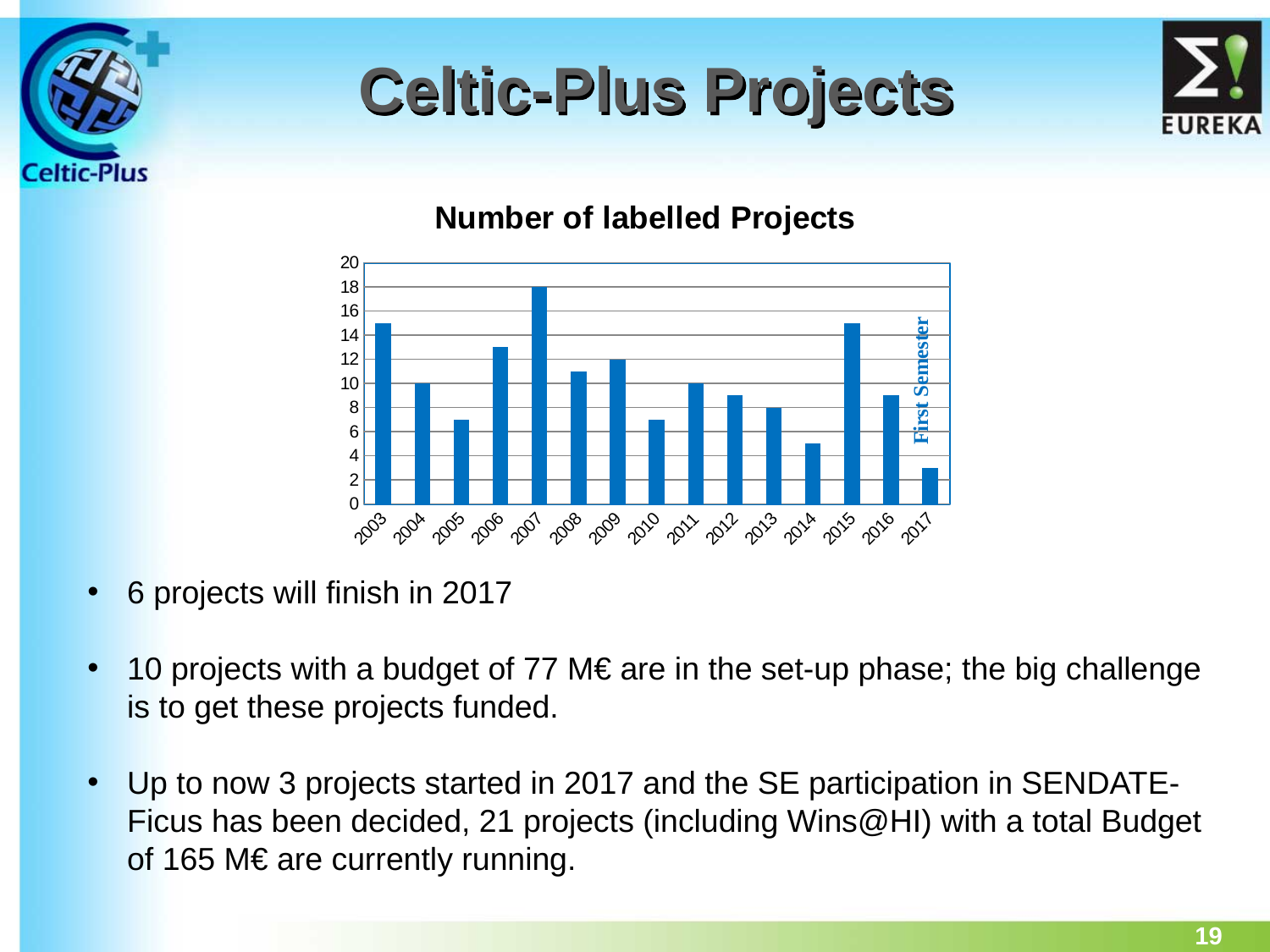
Is the value for 2003 greater or less than 10? greater Which year has the highest number of labelled projects? 2007 What is the number of labelled projects in 2007? 18 How many years are shown on the x axis of the chart? 15 What is the title of the chart? Number of labelled Projects Do the values rise or fall from 2007 to 2010? fall What is the difference between the number of labelled projects in 2007 and in 2009? 6 What is the number of labelled projects in 2009? 12 What is the number of labelled projects in 2013? 8 Which year has the lowest number of labelled projects? 2017 Which year has more labelled projects, 2007 or 2015? 2007 What kind of chart is shown on the slide? bar chart